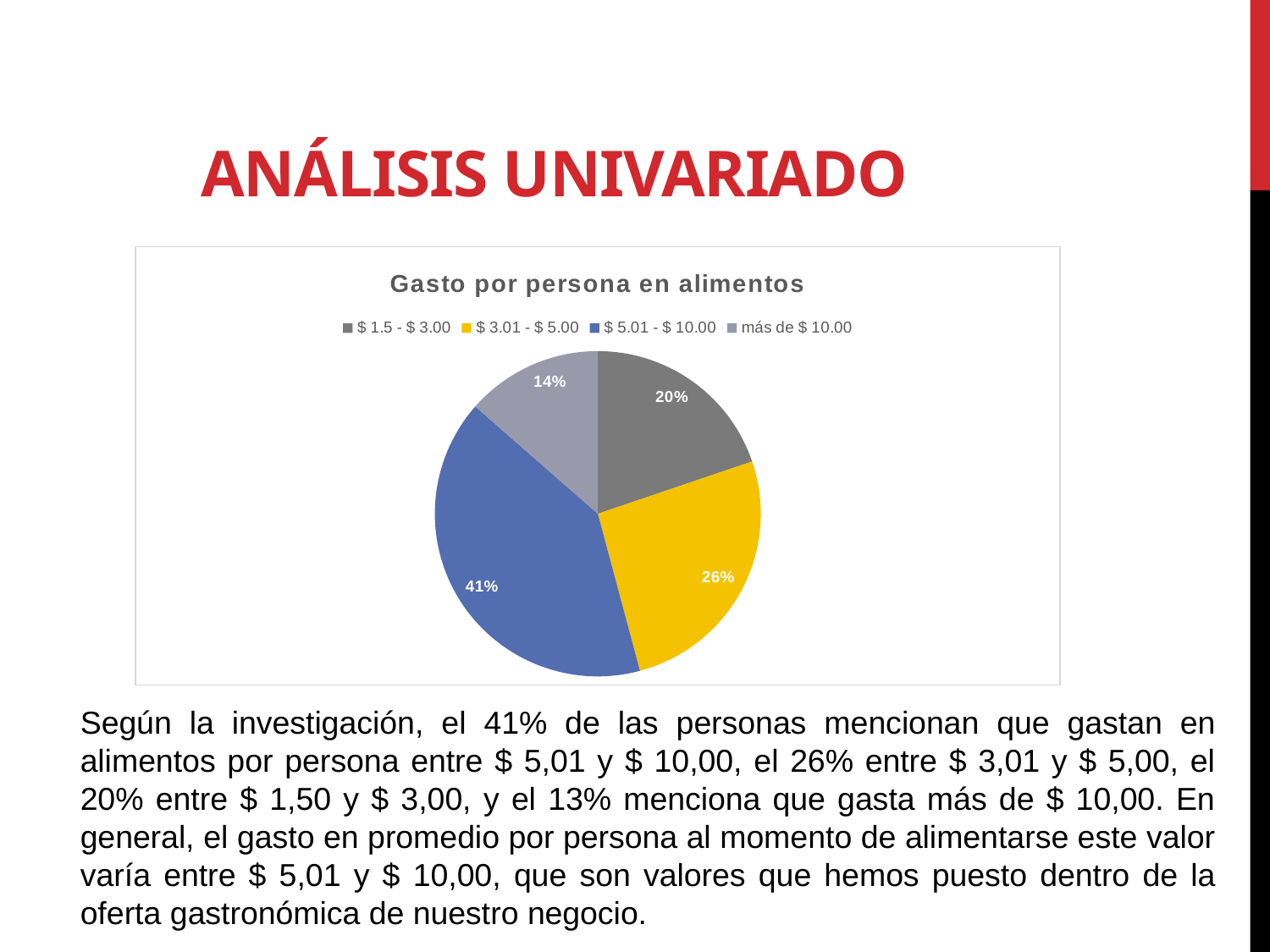
Which is larger, the share for $ 1.5 - $ 3.00 or the share for más de $ 10.00? $ 1.5 - $ 3.00 What kind of chart is shown on the slide? pie chart What percentage of the pie corresponds to $ 3.01 - $ 5.00? 26% What percentage of the pie corresponds to $ 5.01 - $ 10.00? 41% What is the difference in percentage points between the $ 5.01 - $ 10.00 slice and the $ 3.01 - $ 5.00 slice? 15 What is the title of the chart? Gasto por persona en alimentos Which category has the smallest share of the pie? más de $ 10.00 What colour is the slice for $ 3.01 - $ 5.00? yellow What percentage of the pie corresponds to $ 1.5 - $ 3.00? 20% Which category has the largest share of the pie? $ 5.01 - $ 10.00 What percentage of the pie corresponds to más de $ 10.00? 14% How many categories does the pie chart show? 4